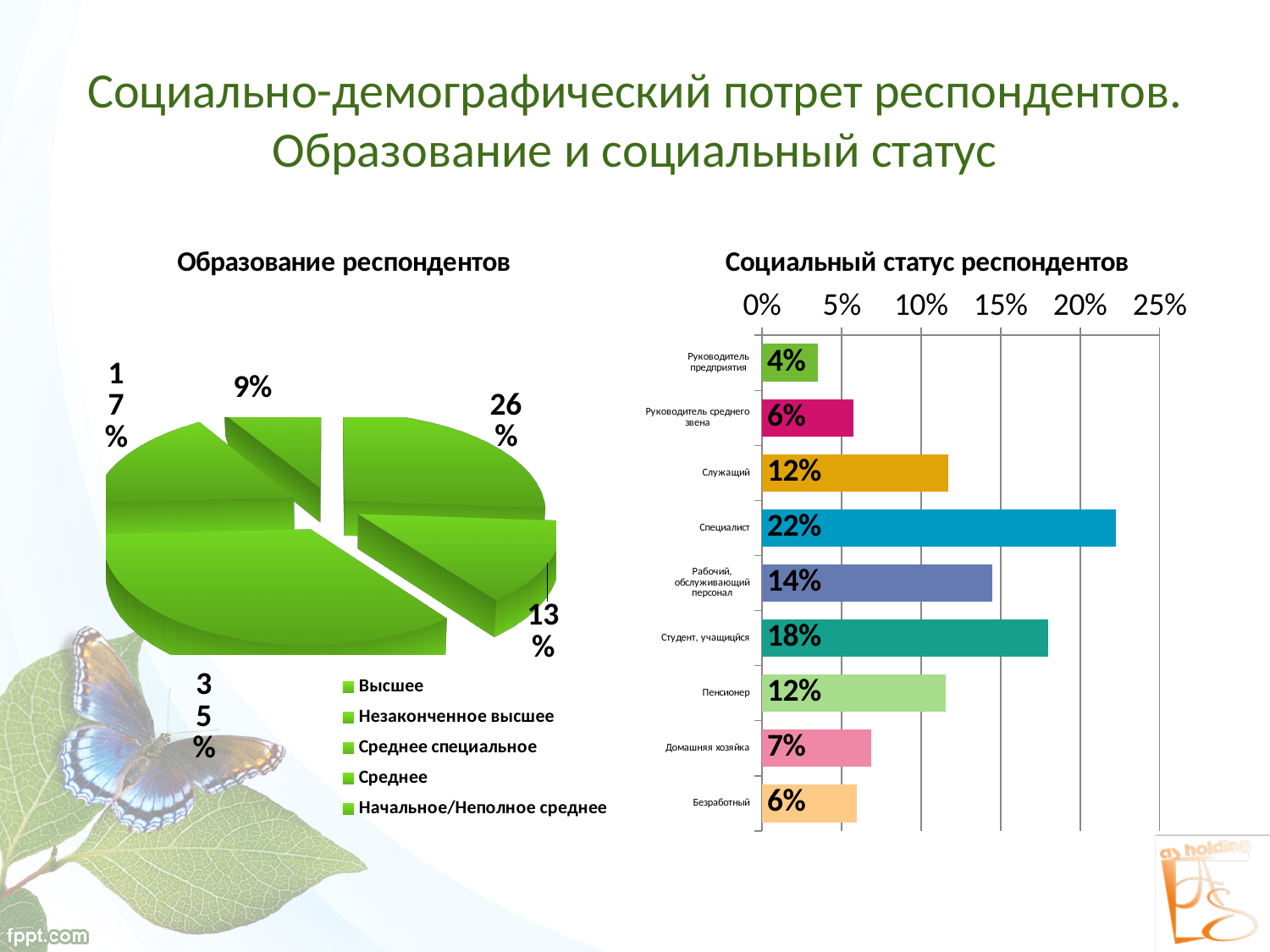
In the chart 'Социальный статус респондентов', what is the value for Домашняя хозяйка? 7% In the chart 'Социальный статус респондентов', what is the value for Специалист? 22% In the chart 'Социальный статус респондентов', what is the difference between the values for Специалист and Рабочий, обслуживающий персонал? 8% In the chart 'Социальный статус респондентов', what is the value for Студент, учащийся? 18% In the chart 'Социальный статус респондентов', which category has the lowest value? Руководитель предприятия How many entries does the legend of the chart 'Образование респондентов' list? 5 In the chart 'Социальный статус респондентов', is the value for Студент, учащийся greater or less than 15%? greater In the chart 'Социальный статус респондентов', which is larger: the value for Пенсионер or the value for Домашняя хозяйка? Пенсионер What kind of chart is 'Социальный статус респондентов'? bar chart How many categories are shown in the chart 'Социальный статус респондентов'? 9 In the chart 'Социальный статус респондентов', which category has the highest value? Специалист What kind of chart is 'Образование респондентов'? pie chart